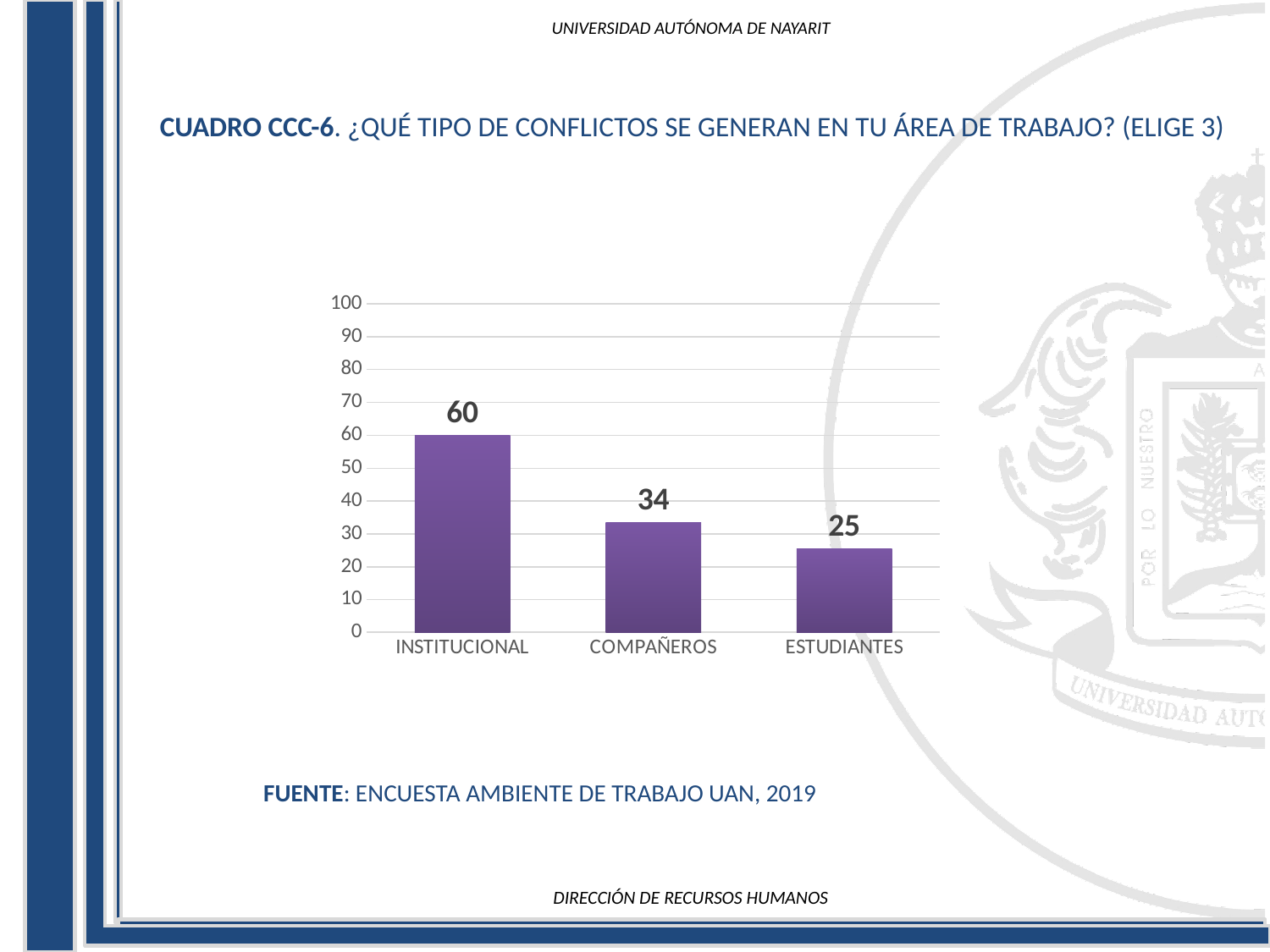
What is the value for INSTITUCIONAL? 60 Which category has the lowest value? ESTUDIANTES Is the value for INSTITUCIONAL greater or less than 50? greater What kind of chart is shown on the slide? bar chart What is the difference between the values for COMPAÑEROS and ESTUDIANTES? 9 How many categories are shown on the chart? 3 What is the value for COMPAÑEROS? 34 What is the value for ESTUDIANTES? 25 Which category has the highest value? INSTITUCIONAL Which is larger, the value for COMPAÑEROS or the value for ESTUDIANTES? COMPAÑEROS Do the values rise or fall from left to right across the categories? fall What is the difference between the values for INSTITUCIONAL and COMPAÑEROS? 26